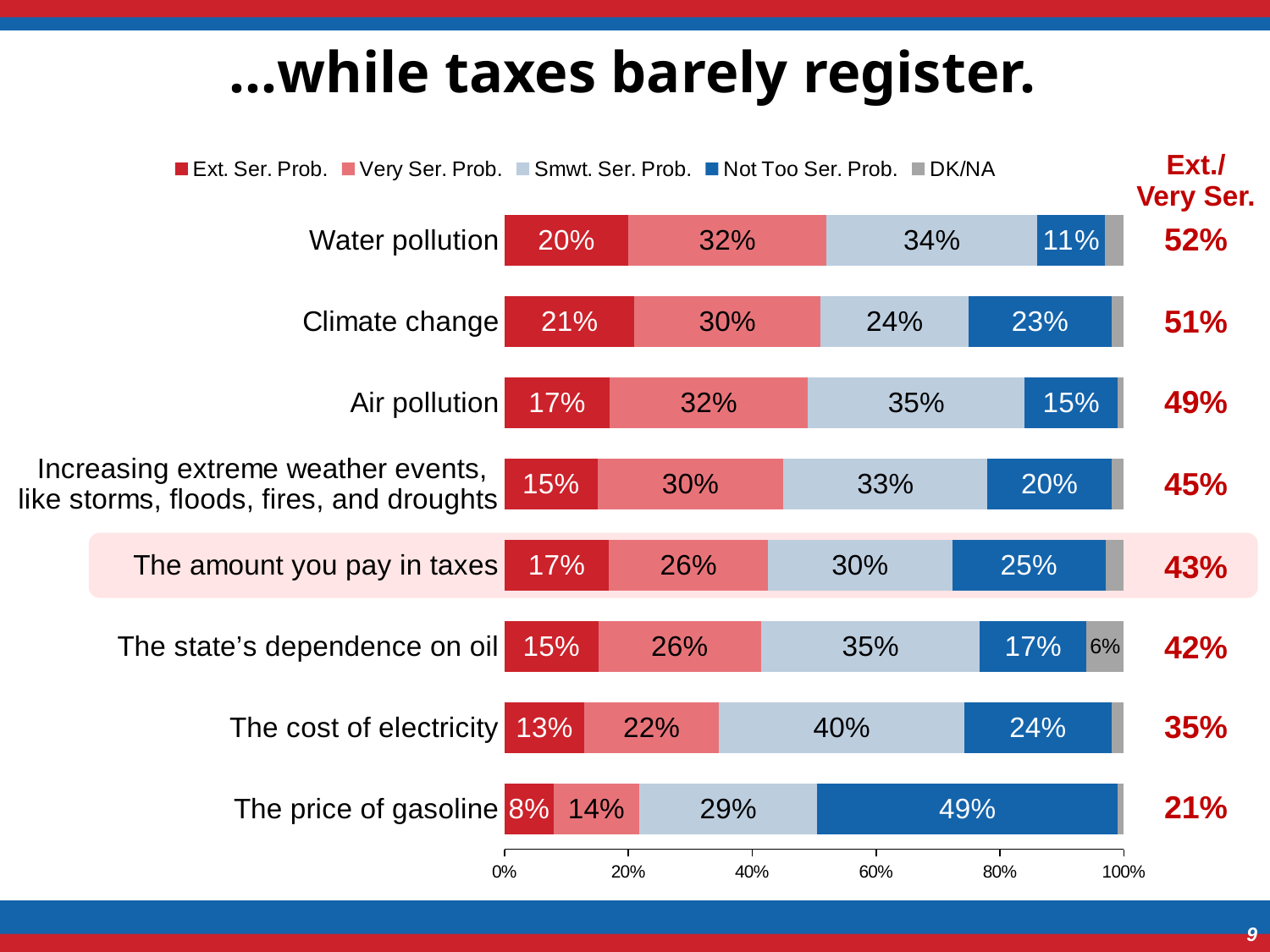
How many series does the legend list? 5 What is the combined Ext./Very Ser. value for the amount you pay in taxes? 43% Which category has the highest Ext. Ser. Prob. value? Climate change Which has a larger Not Too Ser. Prob. value, climate change or air pollution? Climate change What percentage of respondents rated water pollution as an extremely serious problem (Ext. Ser. Prob.)? 20% Which category has the lowest Ext. Ser. Prob. value? The price of gasoline Which category has the highest Smwt. Ser. Prob. value? The cost of electricity What is the Not Too Ser. Prob. value for the price of gasoline? 49% How many categories are shown in the chart? 8 What is the DK/NA value shown for the state's dependence on oil? 6% What kind of chart is shown on the slide? Stacked bar chart How many percentage points higher is the Very Ser. Prob. value for water pollution than for the cost of electricity? 10 percentage points